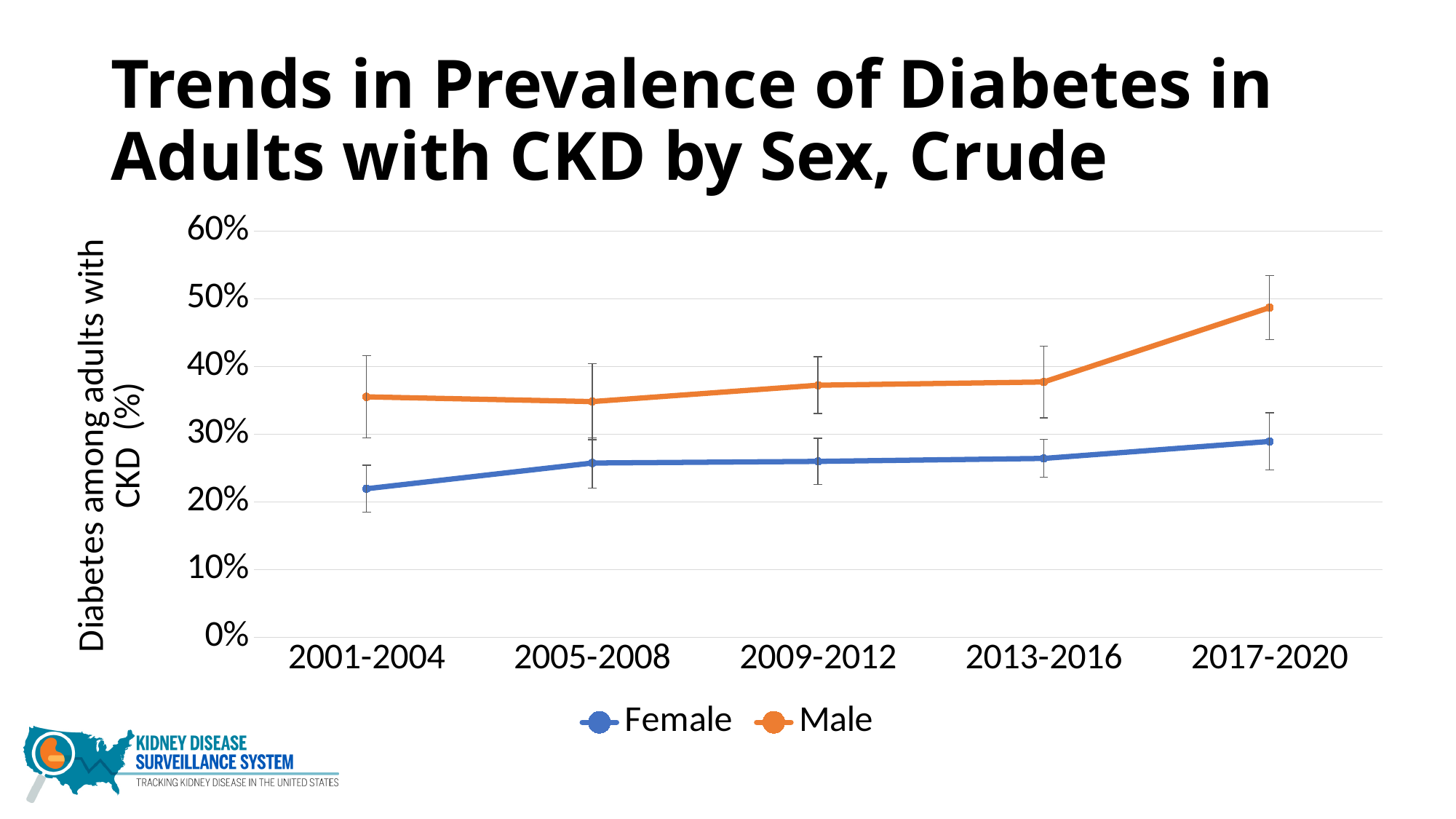
Is the Male value for 2017-2020 greater or less than 40%? greater Which series has the higher value in 2017-2020, Female or Male? Male How many time periods are shown on the x axis? 5 Is the Female value for 2001-2004 greater or less than 30%? less In which period is the Male value highest? 2017-2020 How many series does the legend list? 2 In which period is the Female value lowest? 2001-2004 What is the title of the chart? Trends in Prevalence of Diabetes in Adults with CKD by Sex, Crude Is the Male value for 2005-2008 greater or less than 30%? greater Does the Female line generally rise or fall from 2001-2004 to 2017-2020? rise Which colour represents the Male series? orange What kind of chart is shown on the slide? line chart